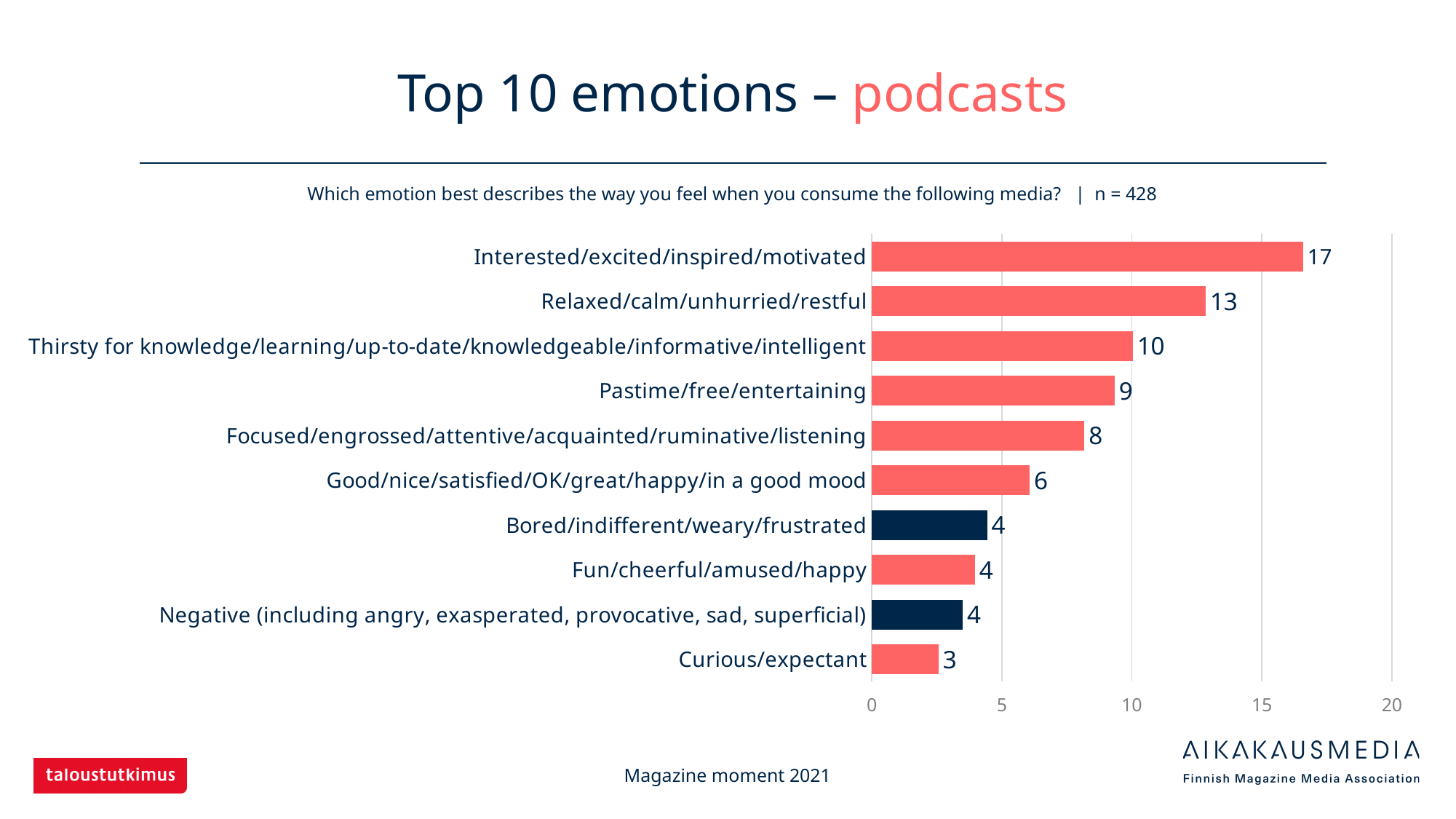
Which emotion has the lowest value? Curious/expectant What kind of chart is shown on the slide? Bar chart Which is larger, the value for Focused/engrossed/attentive/acquainted/ruminative/listening or the value for Good/nice/satisfied/OK/great/happy/in a good mood? Focused/engrossed/attentive/acquainted/ruminative/listening What is the value for Curious/expectant? 3 What is the value for Relaxed/calm/unhurried/restful? 13 Which emotion has the highest value? Interested/excited/inspired/motivated How many emotion categories are shown in the chart? 10 What is the value for Pastime/free/entertaining? 9 What is the value for Interested/excited/inspired/motivated? 17 What is the title of the chart? Top 10 emotions – podcasts What is the difference between the values for Interested/excited/inspired/motivated and Relaxed/calm/unhurried/restful? 4 What is the sample size (n) stated on the slide? 428